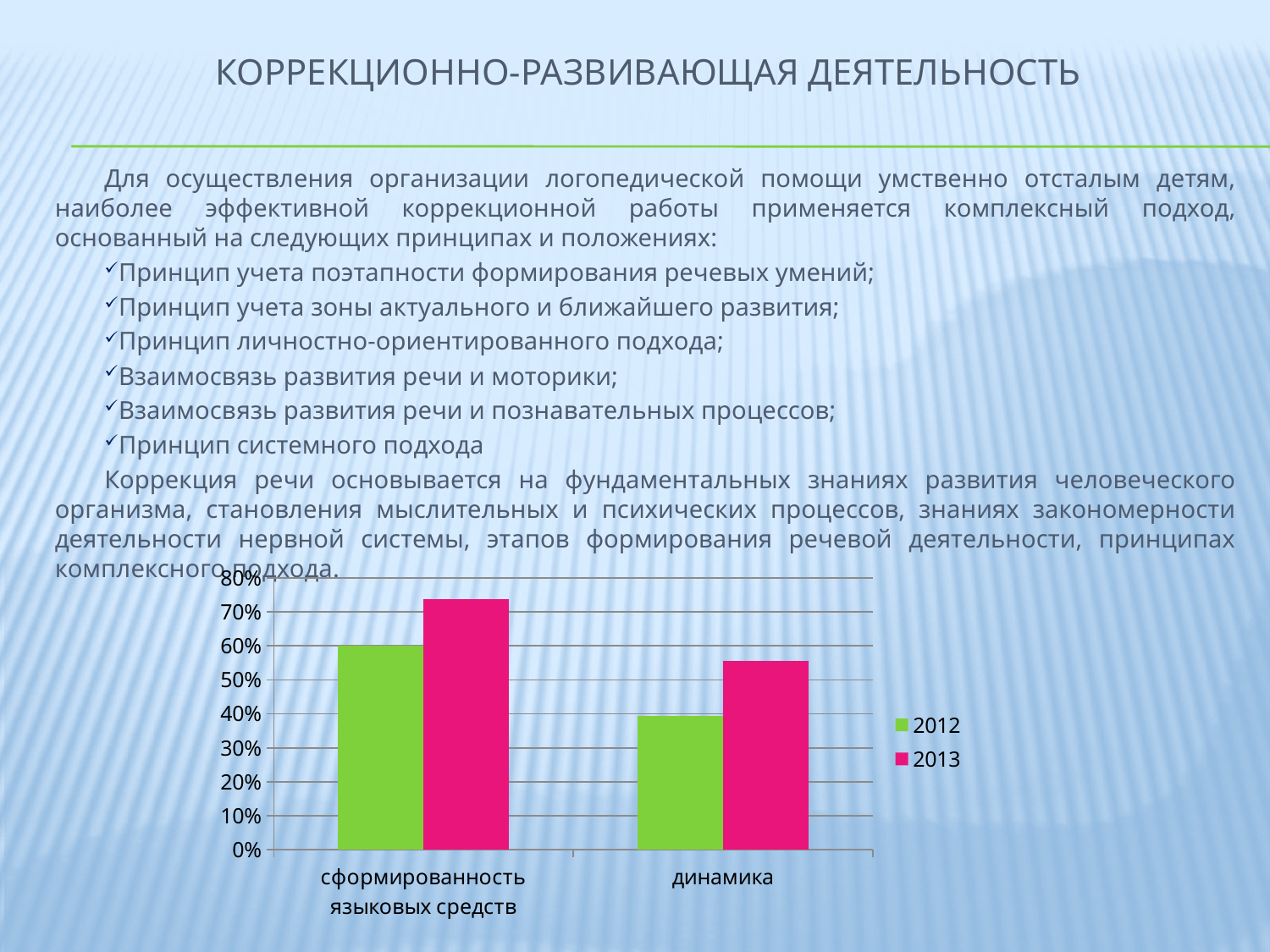
Is the 2012 value for 'динамика' greater or less than 50%? less How many categories are shown on the x axis of the chart? 2 Which category has the highest value for the 2013 series? сформированность языковых средств For 'сформированность языковых средств', which year has the larger value, 2012 or 2013? 2013 What are the entries in the chart legend? 2012, 2013 How many series does the chart legend list? 2 Which bar is the lowest in the chart? 2012 for динамика What kind of chart is shown on the slide? bar chart Is the 2013 value for 'сформированность языковых средств' greater or less than 70%? greater What colour represents the 2013 series in the chart? pink Is the 2013 value for 'динамика' greater or less than 50%? greater For 'динамика', which year has the larger value, 2012 or 2013? 2013